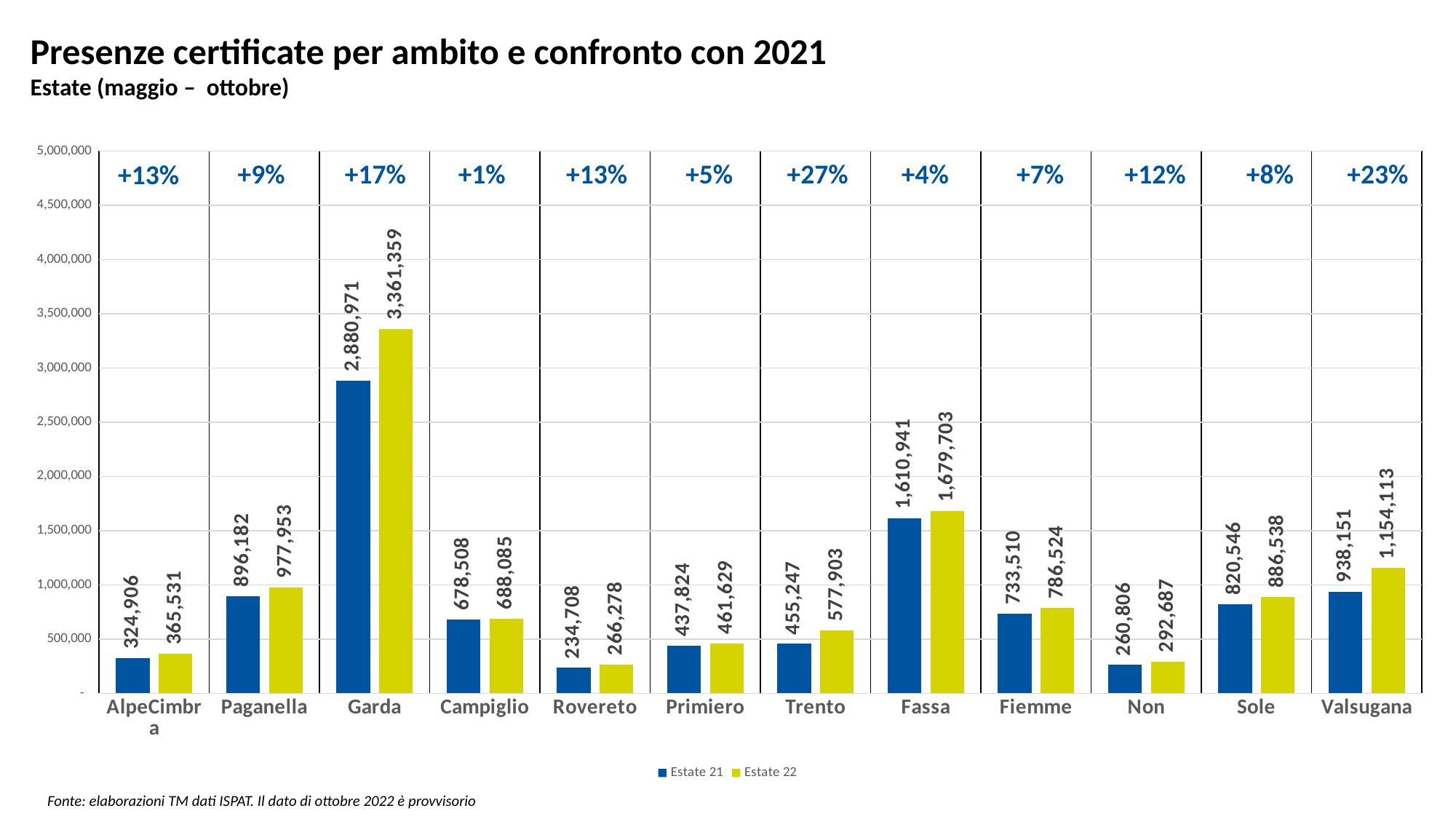
What is the Estate 21 value for Valsugana? 938,151 What is the Estate 22 value for Garda? 3,361,359 Which ambito has the lowest Estate 21 value? Rovereto What percentage change is shown above Trento? +27% What is the Estate 22 value for Trento? 577,903 What kind of chart is shown on the slide? bar chart Is the Estate 22 value for Paganella greater or less than 1,000,000? less Which is larger, the Estate 22 value for Fassa or the Estate 22 value for Valsugana? Fassa What is the difference between the Estate 22 and Estate 21 values for Garda? 480,388 How many ambiti (categories) are shown on the x axis? 12 How many series does the legend list? 2 Which ambito has the highest Estate 22 value? Garda